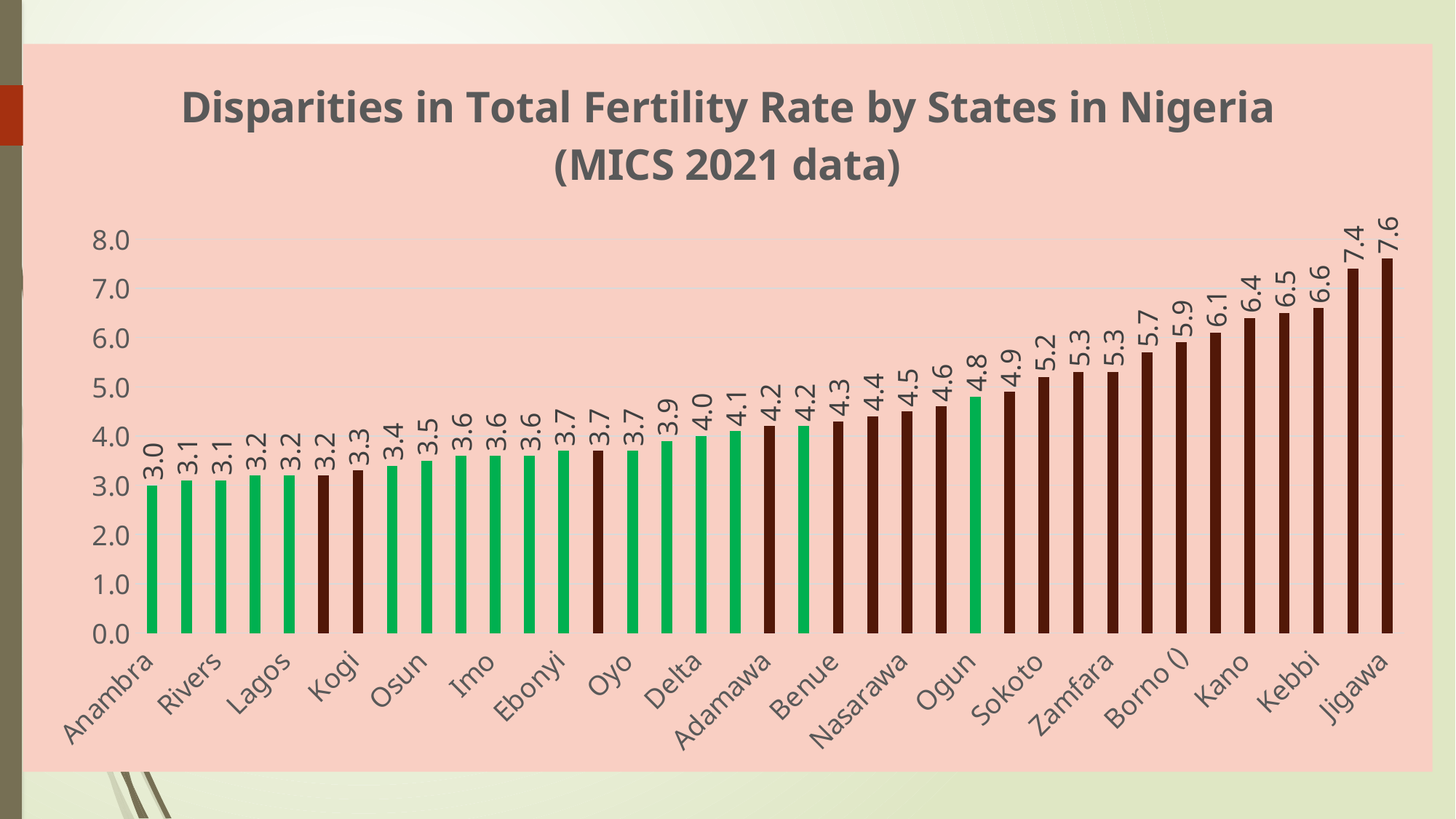
What is the total fertility rate for Kano? 6.4 Which has a higher total fertility rate, Kebbi or Kano? Kebbi What is the total fertility rate for Sokoto? 5.2 What is the total fertility rate for Ogun? 4.8 Do the values rise or fall from left to right along the x axis? rise What is the total fertility rate for Jigawa? 7.6 What kind of chart is shown on the slide? bar chart What is the total fertility rate for Anambra? 3.0 Is the value for Borno greater or less than 5.0? greater Which state has the lowest total fertility rate? Anambra What is the difference between the total fertility rates of Jigawa and Anambra? 4.6 Which state has the highest total fertility rate? Jigawa